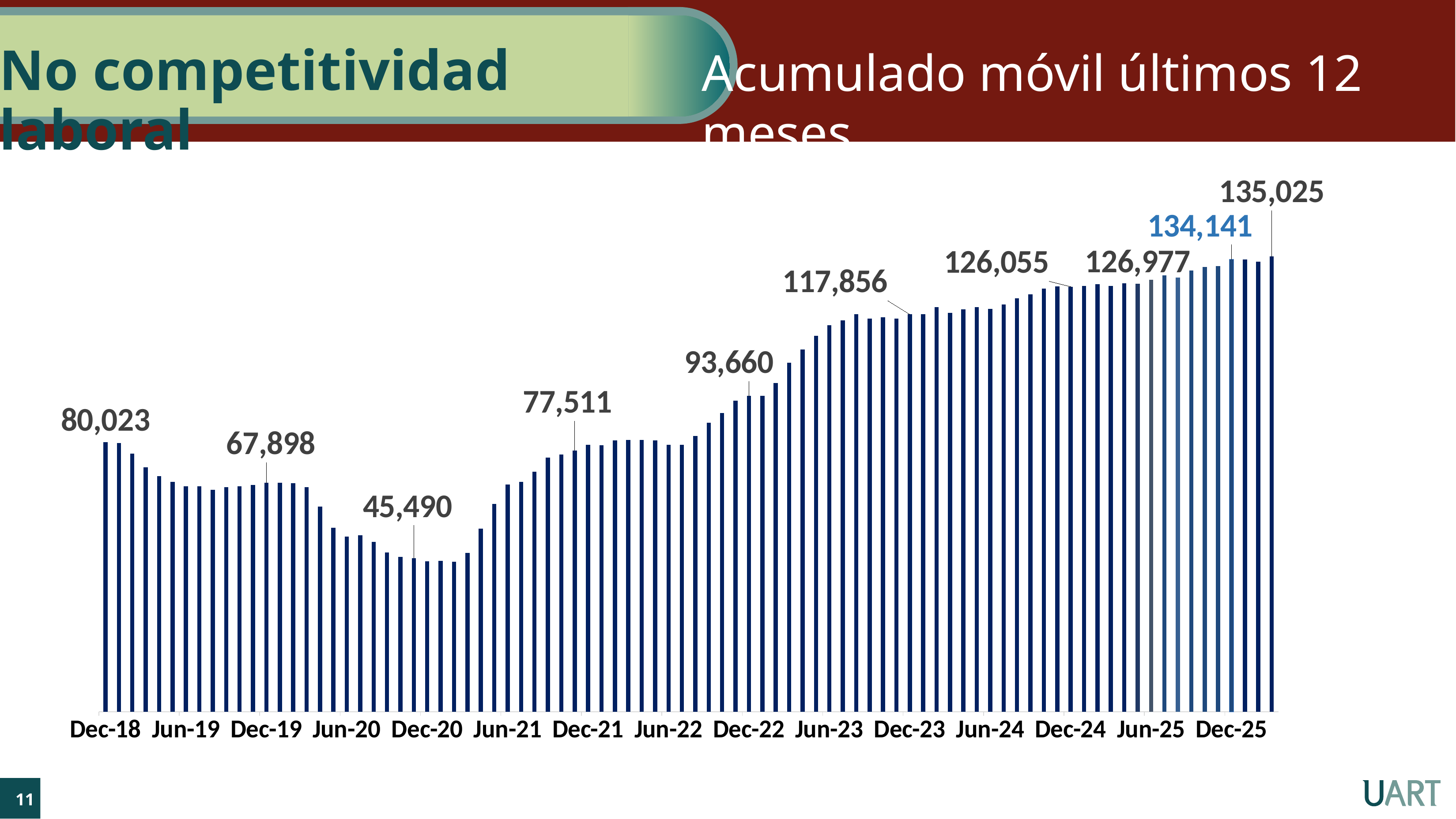
What is the value labelled for Dec-23? 117,856 Which of the labelled values is the lowest? 45,490 What is the difference between the Dec-21 value (77,511) and the Dec-20 value (45,490)? 32,021 Do the values generally rise or fall from Dec-20 to Dec-25? rise What is the value labelled for Dec-18? 80,023 Which of the labelled values is the highest? 135,025 What is the value labelled on the last (rightmost) bar of the chart? 135,025 What kind of chart is shown on the slide? bar chart Which is larger, the value for Dec-19 or the value for Dec-22? Dec-22 What is the value labelled for Dec-22? 93,660 What is the difference between the Dec-24 value (126,055) and the Dec-23 value (117,856)? 8,199